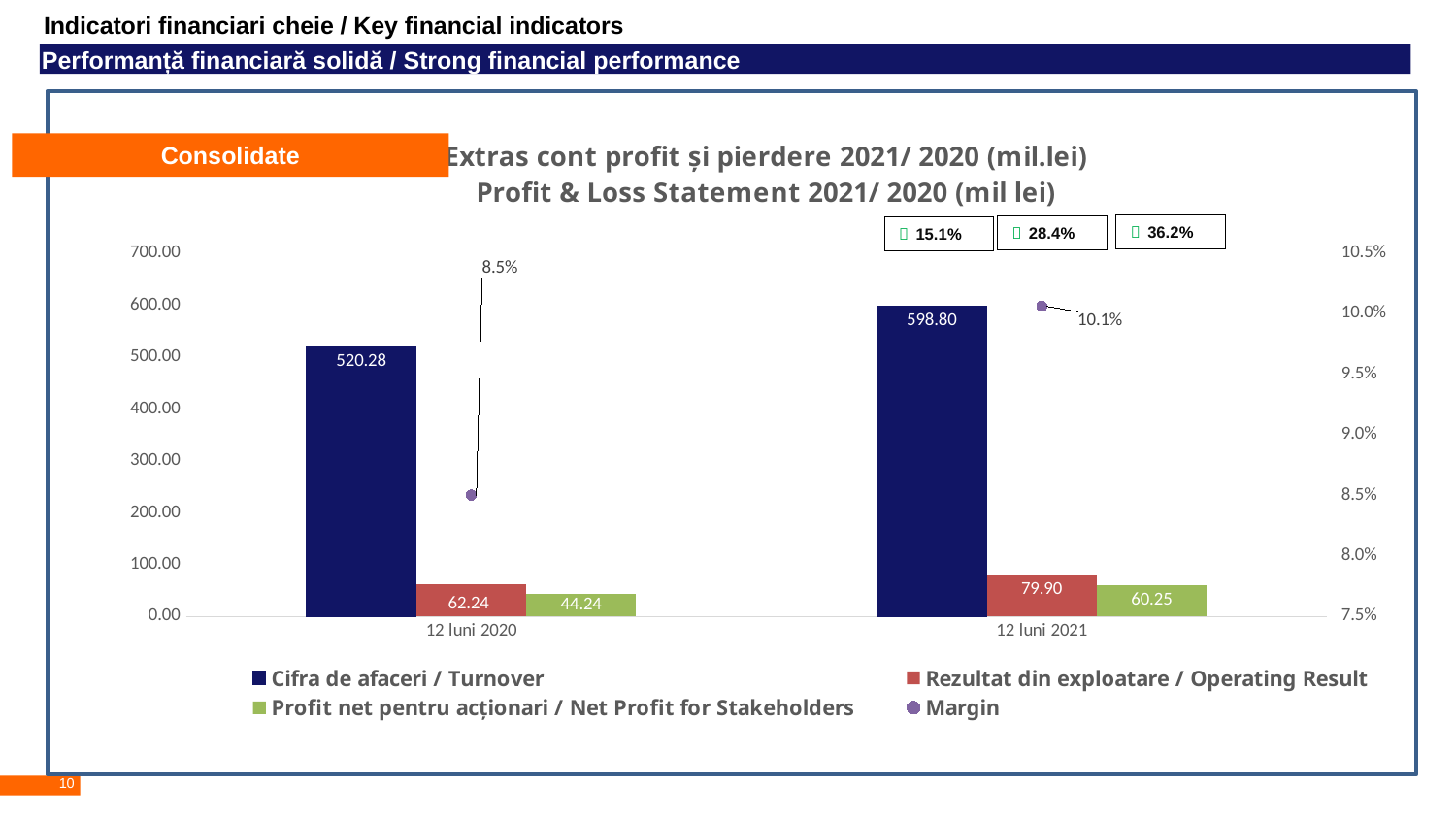
Which period has the higher Cifra de afaceri / Turnover? 12 luni 2021 What is the difference in Cifra de afaceri / Turnover between 12 luni 2021 and 12 luni 2020? 78.52 How many series does the legend list? 4 Which series is plotted as points rather than bars? Margin What is the value of Profit net pentru acționari / Net Profit for Stakeholders for 12 luni 2020? 44.24 What is the value of Cifra de afaceri / Turnover for 12 luni 2021? 598.80 What is the difference in Profit net pentru acționari / Net Profit for Stakeholders between 12 luni 2021 and 12 luni 2020? 16.01 What is the Margin for 12 luni 2021? 10.1% Does the Margin rise or fall from 12 luni 2020 to 12 luni 2021? rise What is the value of Rezultat din exploatare / Operating Result for 12 luni 2020? 62.24 Is the Rezultat din exploatare / Operating Result for 12 luni 2021 larger or smaller than for 12 luni 2020? larger How many periods are shown on the x axis? 2